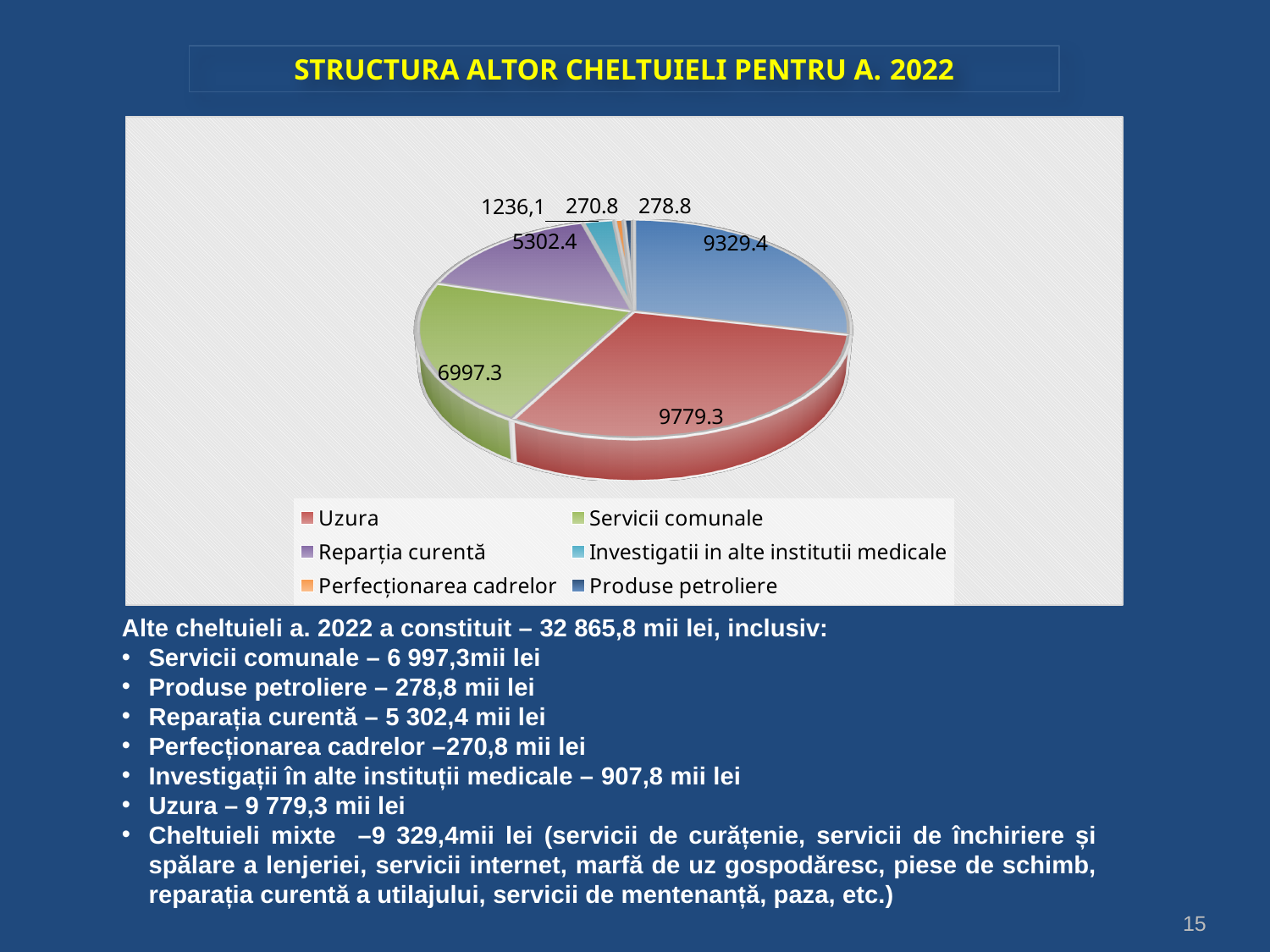
What is the value of the Reparția curentă slice? 5302.4 Which legend category has the largest slice in the pie chart? Uzura How many entries does the chart legend list? 6 What is the value of the Produse petroliere slice? 278.8 What is the difference between the Reparția curentă value and the Produse petroliere value? 5023.6 What is the title of the slide above the chart? STRUCTURA ALTOR CHELTUIELI PENTRU A. 2022 What is the value of the Servicii comunale slice? 6997.3 What kind of chart is shown on the slide? pie chart Which is larger, the Servicii comunale slice or the Reparția curentă slice? Servicii comunale What is the value of the Uzura slice? 9779.3 What is the difference between the Uzura value and the Servicii comunale value? 2782 What is the value of the Perfecționarea cadrelor slice? 270.8